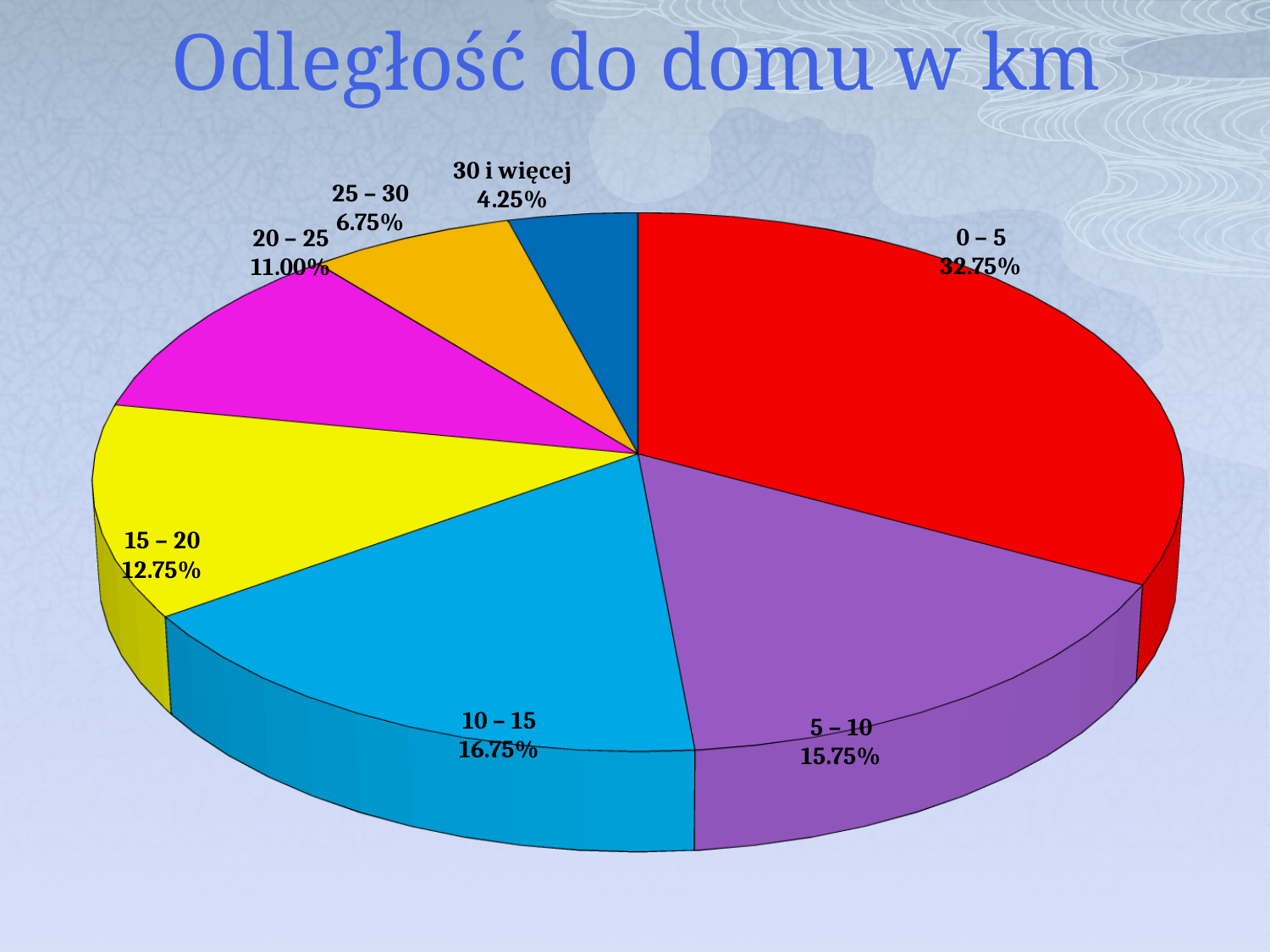
What is the title of the chart? Odległość do domu w km What share does the 0 – 5 slice have? 32.75% What kind of chart is shown on the slide? pie chart What share does the 30 i więcej slice have? 4.25% Which category has the largest share? 0 – 5 How many slices does the pie chart have? 7 What share does the 20 – 25 slice have? 11.00% Which category has the smallest share? 30 i więcej Which is larger, the share of 15 – 20 or the share of 25 – 30? 15 – 20 What colour is the 5 – 10 slice? purple What share does the 10 – 15 slice have? 16.75% What is the difference between the shares of 0 – 5 and 5 – 10? 17.00%